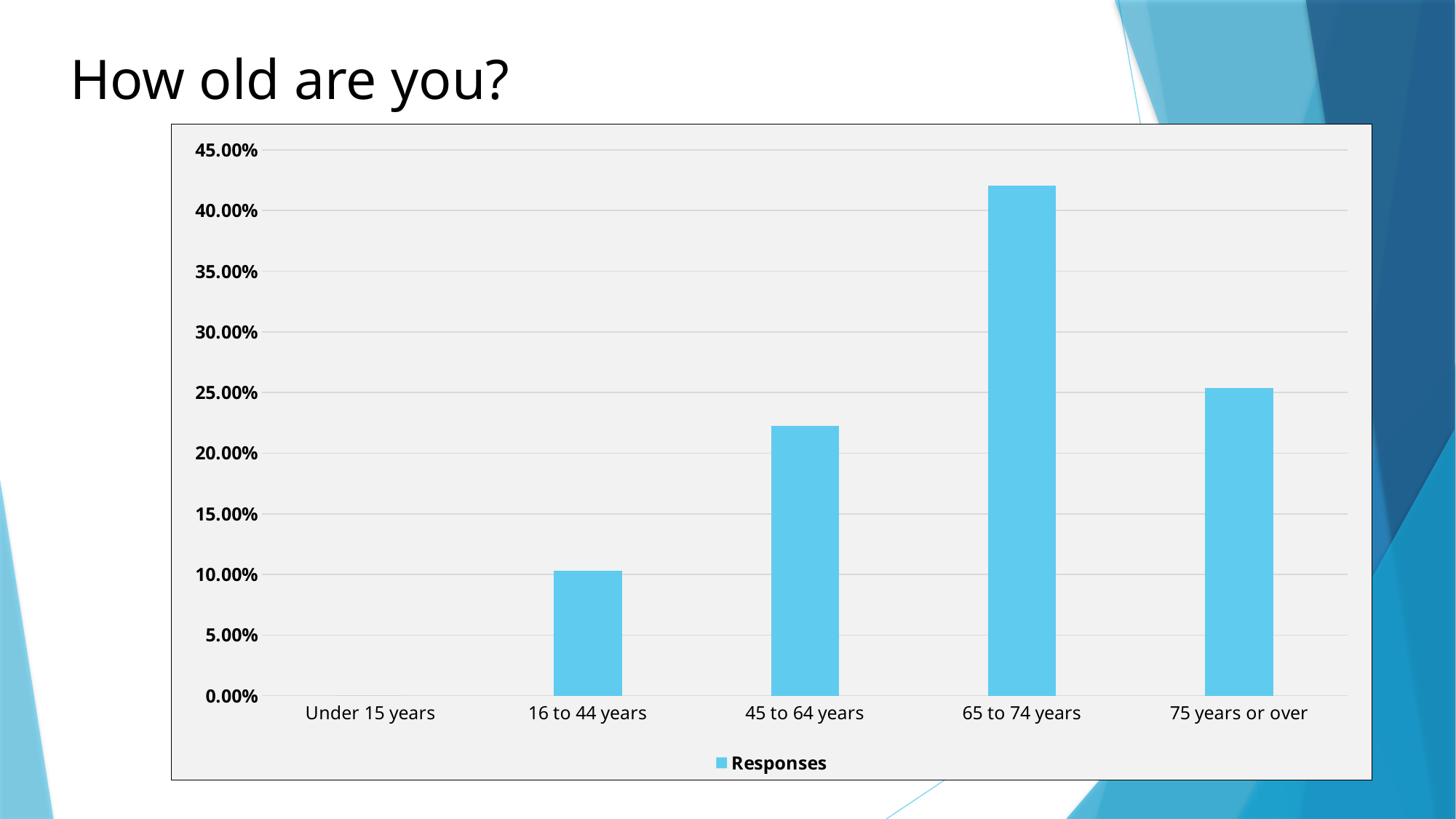
What is the value for Under 15 years? 0.00% Which is larger, the value for 16 to 44 years or the value for 45 to 64 years? 45 to 64 years Which age category has the lowest value? Under 15 years How many series does the legend list? 1 What is the name of the series shown in the legend? Responses Is the value for 65 to 74 years greater or less than 40.00%? greater Is the value for 16 to 44 years greater or less than 15.00%? less How many age categories are shown on the x axis? 5 Which age category has the highest value? 65 to 74 years What kind of chart is shown on the slide? bar chart Is the value for 45 to 64 years greater or less than 20.00%? greater